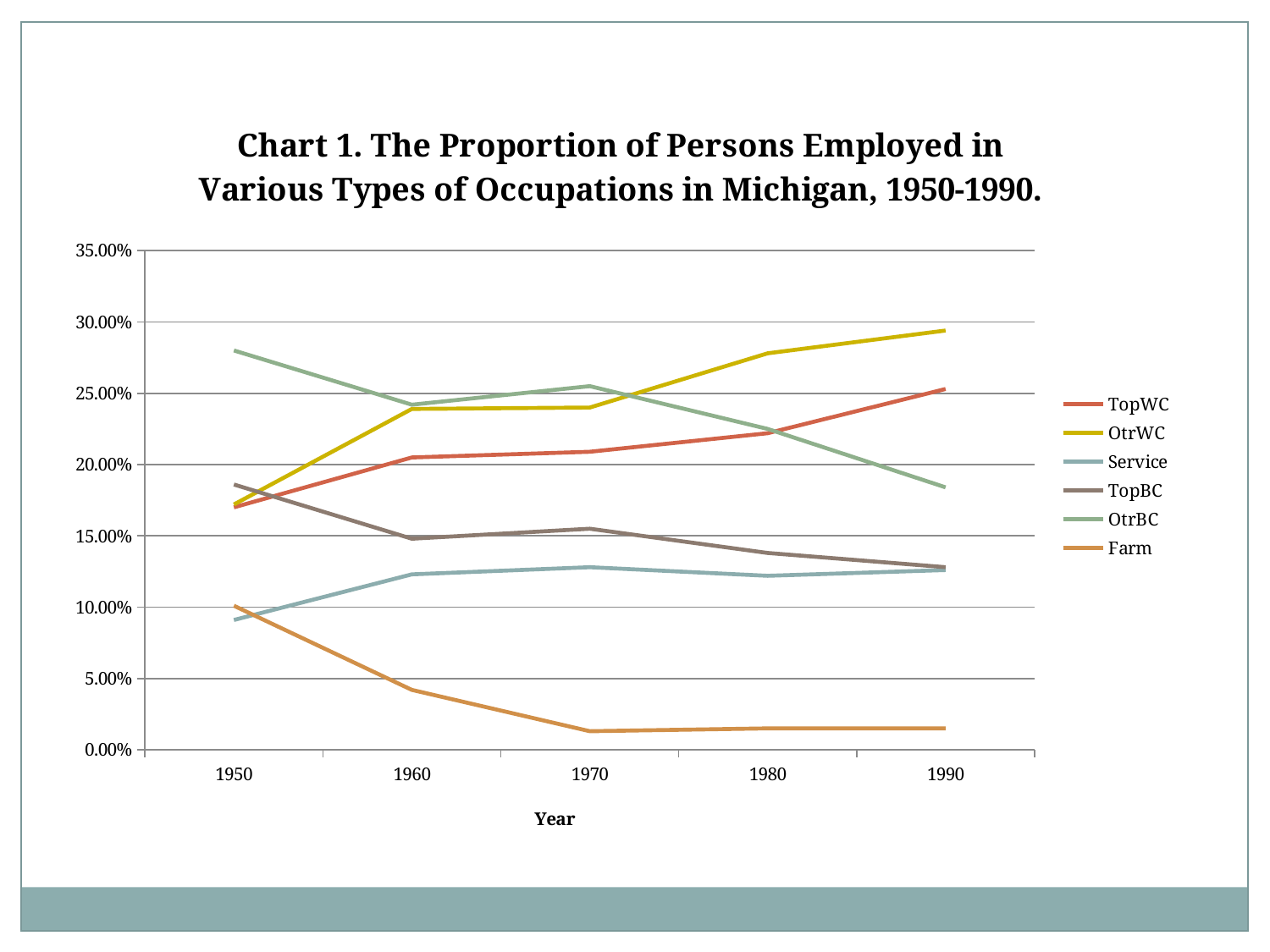
Which series has the highest value in 1950? OtrBC Is the value for OtrBC in 1950 greater or less than 25.00%? greater What kind of chart is shown on the slide? line chart Does the OtrBC series rise or fall from 1950 to 1990? fall Is the value for Farm in 1970 greater or less than 5.00%? less How many series does the legend list? 6 Does the OtrWC series rise or fall from 1950 to 1990? rise How many years are plotted along the x axis? 5 Does the Farm series rise or fall from 1950 to 1990? fall What is the title of the x axis? Year Which series has the highest value in 1990? OtrWC Which series has the lowest value in 1990? Farm